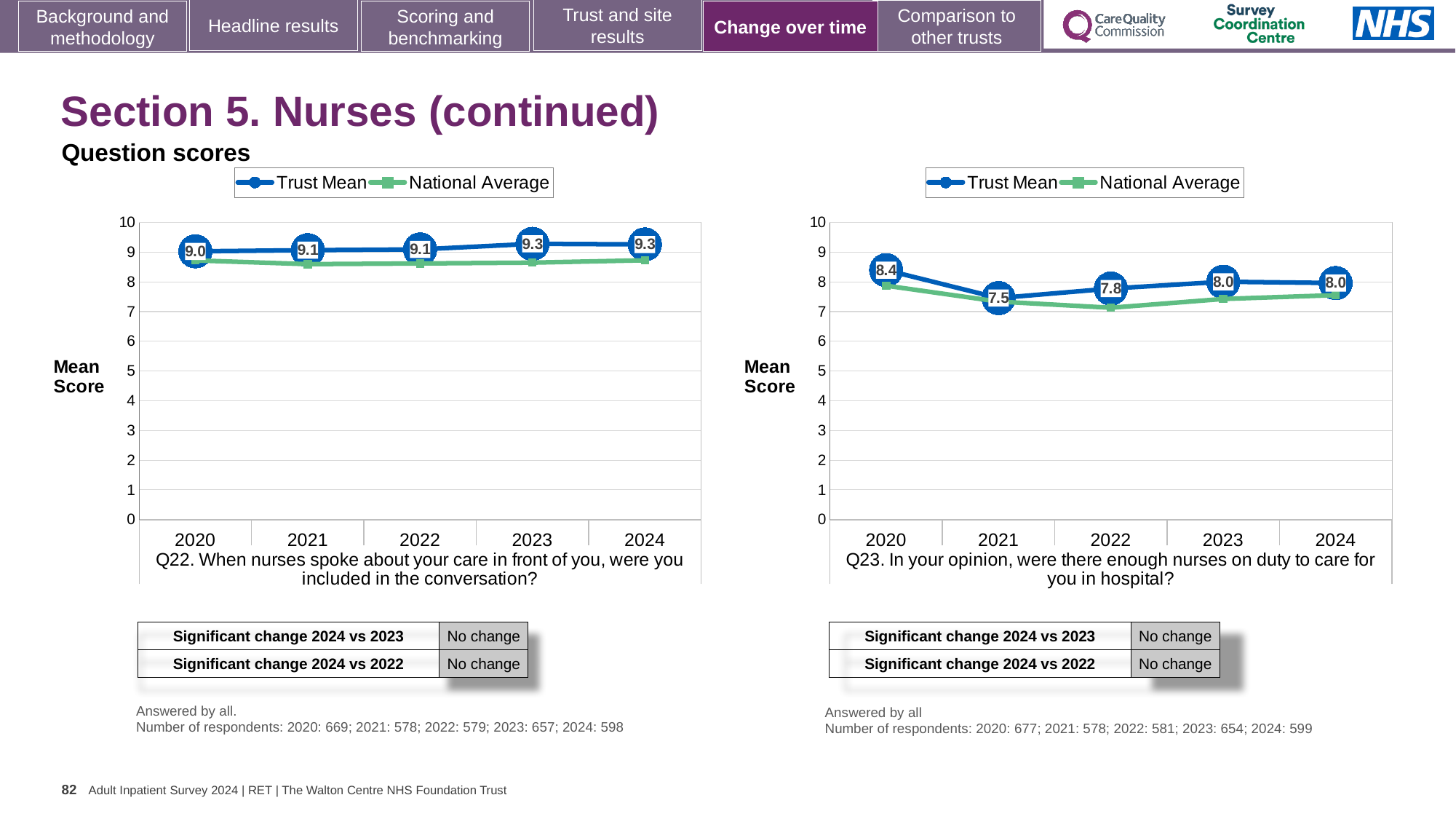
On the Q22 chart (left), what is the Trust Mean score for 2020? 9.0 On the Q22 chart (left), what is the Trust Mean score for 2024? 9.3 On the Q22 chart (left), how many years are plotted on the x axis? 5 On the Q23 chart (right), what is the Trust Mean score for 2020? 8.4 On the Q23 chart (right), which year has the lowest Trust Mean score? 2021 On the Q23 chart (right), is the Trust Mean score for 2022 greater or less than 8? less On the Q22 chart (left), what is the difference between the Trust Mean scores for 2024 and 2020? 0.3 On the Q23 chart (right), what is the Trust Mean score for 2021? 7.5 On the Q23 chart (right), which year has the highest Trust Mean score? 2020 On the Q23 chart (right), what is the difference between the Trust Mean scores for 2020 and 2021? 0.9 On the Q23 chart (right), how many series does the legend list? 2 What type of chart is used for the Q22 question scores on the left? Line chart